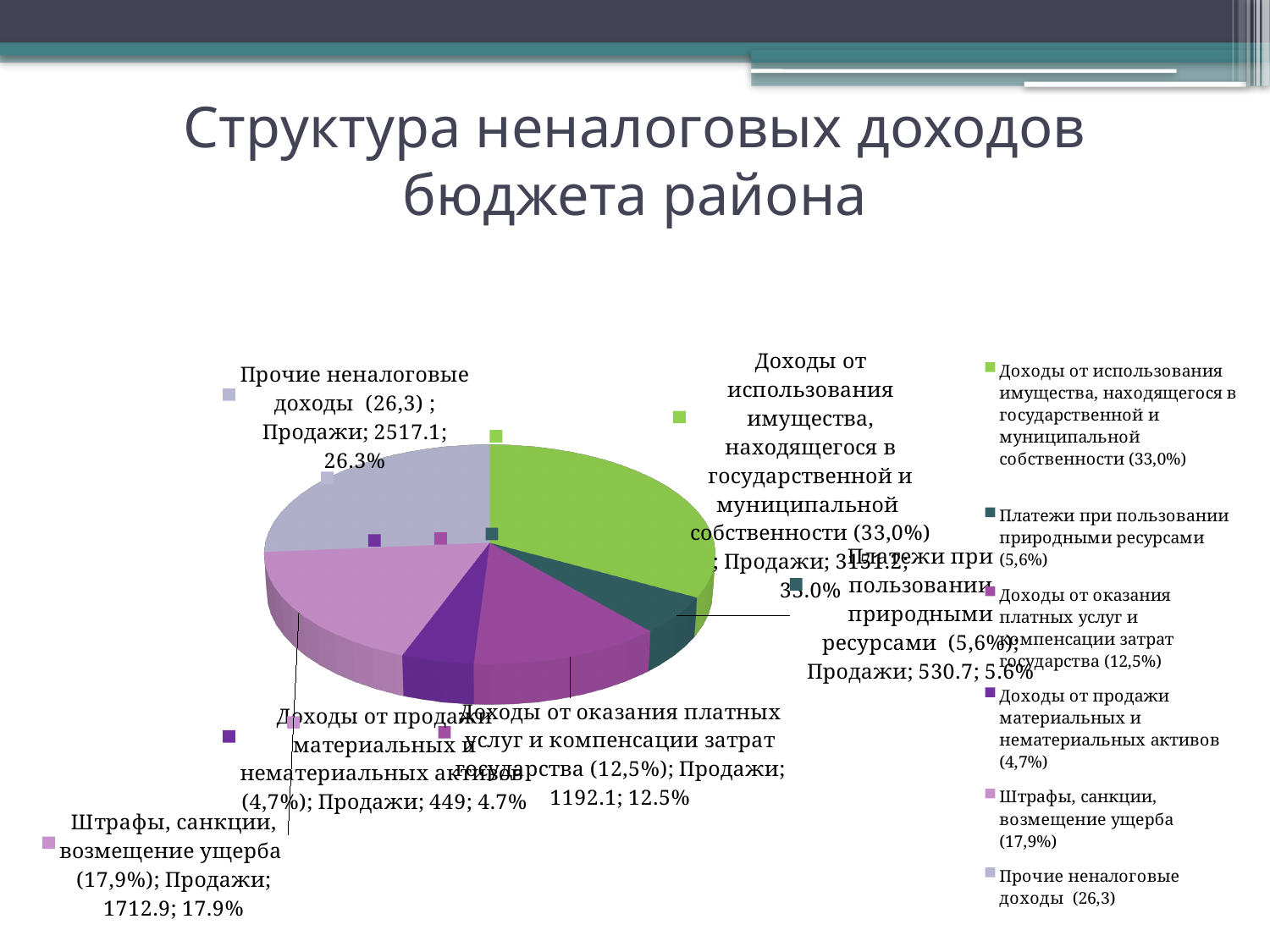
What share of the pie does Доходы от продажи материальных и нематериальных активов represent? 4.7% Which category has the smallest share of the pie? Доходы от продажи материальных и нематериальных активов What is the title of the slide containing the chart? Структура неналоговых доходов бюджета района Which is larger: the value for Штрафы, санкции, возмещение ущерба or the value for Доходы от оказания платных услуг и компенсации затрат государства? Штрафы, санкции, возмещение ущерба What is the value shown for Штрафы, санкции, возмещение ущерба? 1712.9 What kind of chart is shown on the slide? pie chart What share of the pie does Доходы от оказания платных услуг и компенсации затрат государства represent? 12.5% Which category has the largest share of the pie? Доходы от использования имущества, находящегося в государственной и муниципальной собственности How many slices does the pie chart have? 6 What is the difference between the values for Прочие неналоговые доходы and Штрафы, санкции, возмещение ущерба? 804.2 What is the value shown for Прочие неналоговые доходы? 2517.1 What is the value shown for Платежи при пользовании природными ресурсами? 530.7